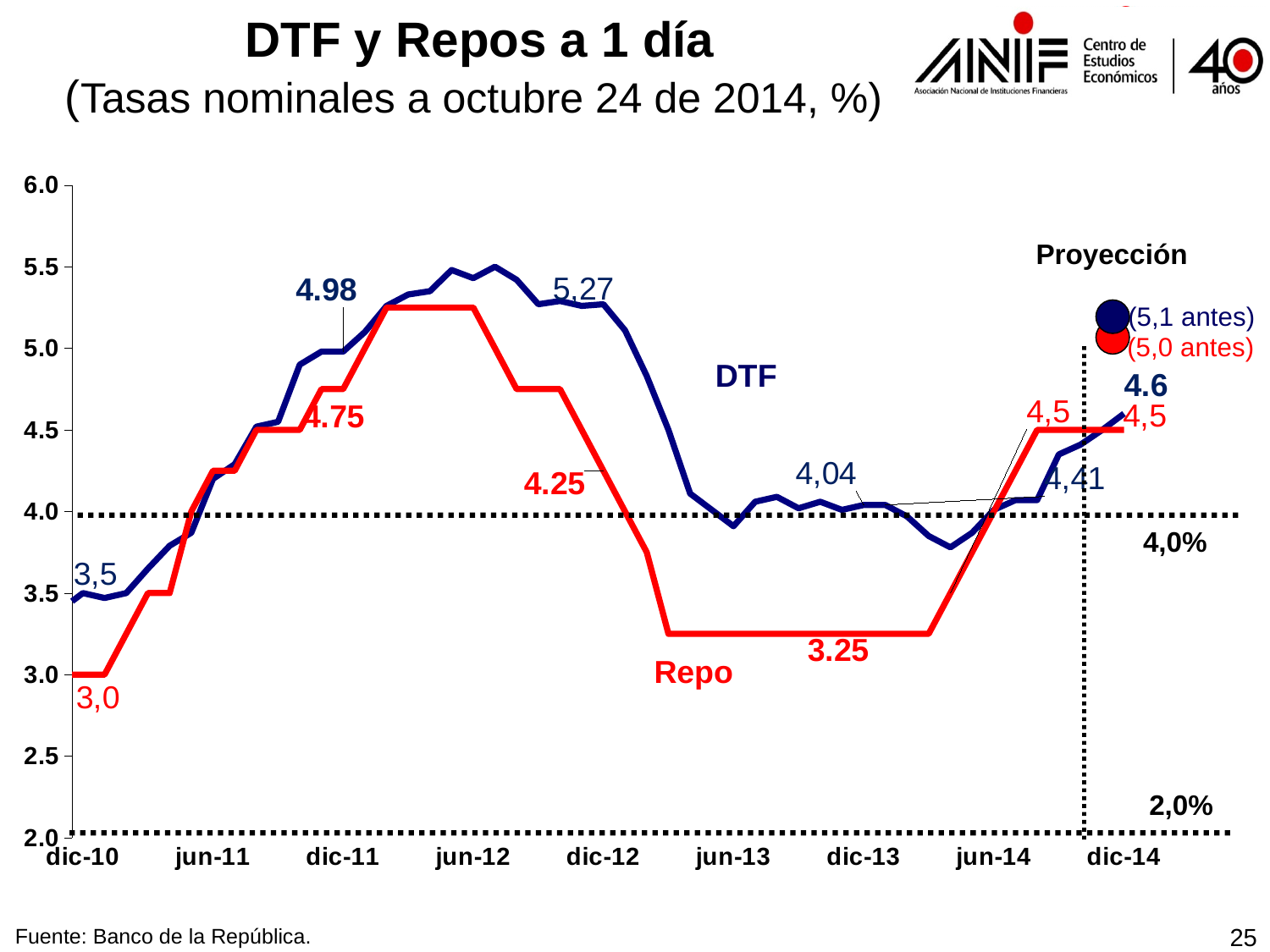
Which series has the higher labelled value at dic-10, DTF or Repo? DTF What was the previous projection for the DTF series, as shown in the legend note? 5,1 What is the labelled value of the DTF series at dic-10? 3,5 What is the projected value of the DTF series at dic-14? 4.6 What is the labelled value of the Repo series at dic-10? 3,0 What kind of chart is shown on the slide? line chart What is the title of the chart? DTF y Repos a 1 día What is the labelled value of the Repo series during its flat stretch in 2013? 3.25 What is the projected value of the Repo series at dic-14? 4,5 Is the value of the Repo series at jun-13 greater or less than 3.5? less How many series are plotted on the chart? 2